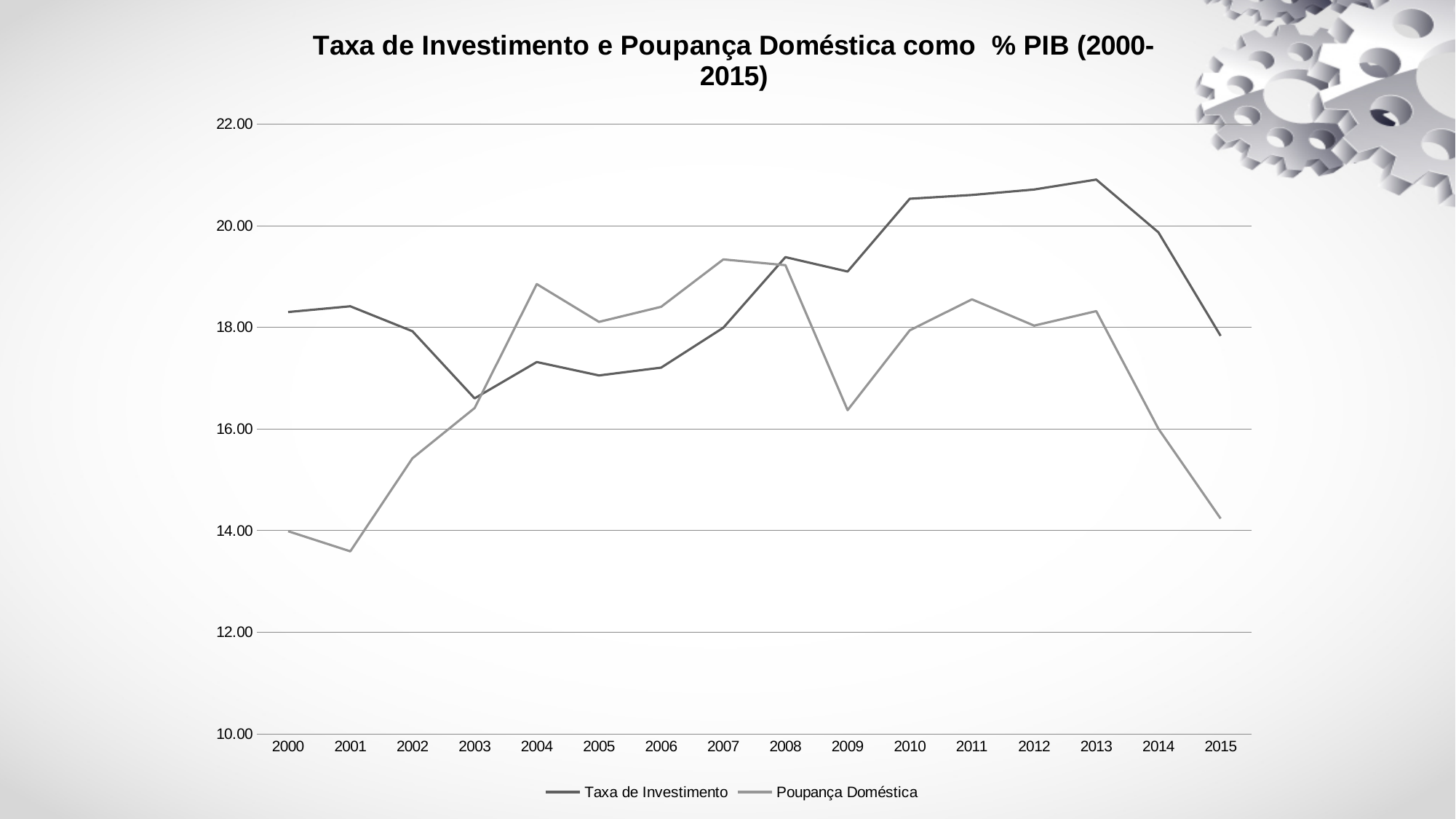
In 2015, which series has the larger value, Taxa de Investimento or Poupança Doméstica? Taxa de Investimento In which year does Taxa de Investimento reach its highest value? 2013 Is the value for Poupança Doméstica in 2009 greater or less than 18.00? less Does Poupança Doméstica rise or fall from 2013 to 2015? fall How many series does the legend list? 2 In which year is Poupança Doméstica at its lowest? 2001 What kind of chart is shown on the slide? line chart How many years are plotted along the x axis? 16 Is the value for Taxa de Investimento in 2013 greater or less than 20.00? greater Is the value for Poupança Doméstica in 2015 greater or less than 16.00? less In which year is Taxa de Investimento at its lowest? 2003 In 2004, which series has the larger value, Taxa de Investimento or Poupança Doméstica? Poupança Doméstica